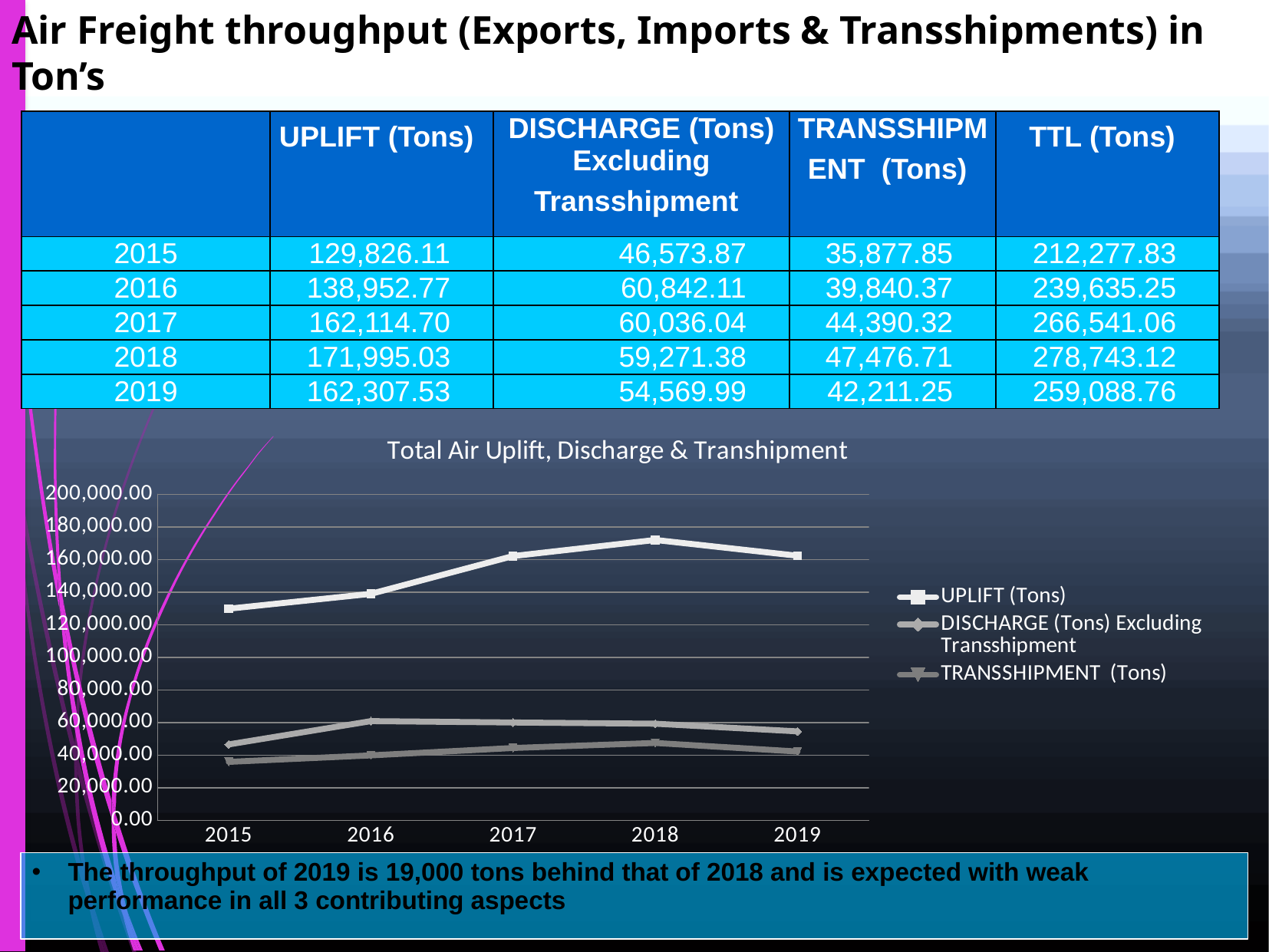
Does the UPLIFT (Tons) series rise or fall from 2015 to 2018? rise In which year is the UPLIFT (Tons) series at its lowest? 2015 In which year is the UPLIFT (Tons) series at its highest? 2018 By how much did UPLIFT (Tons) fall from 2018 to 2019? 9,687.50 What is the UPLIFT (Tons) value for 2018? 171,995.03 Is the UPLIFT (Tons) value for 2015 greater or less than 140,000.00? less Is the DISCHARGE (Tons) Excluding Transshipment value for 2015 greater or less than 40,000.00? greater What kind of chart is shown on the slide? line chart In 2017, which series is larger: UPLIFT (Tons) or DISCHARGE (Tons) Excluding Transshipment? UPLIFT (Tons) What is the title of the chart? Total Air Uplift, Discharge & Transhipment How many series does the chart's legend list? 3 How many years are plotted along the x axis of the chart? 5